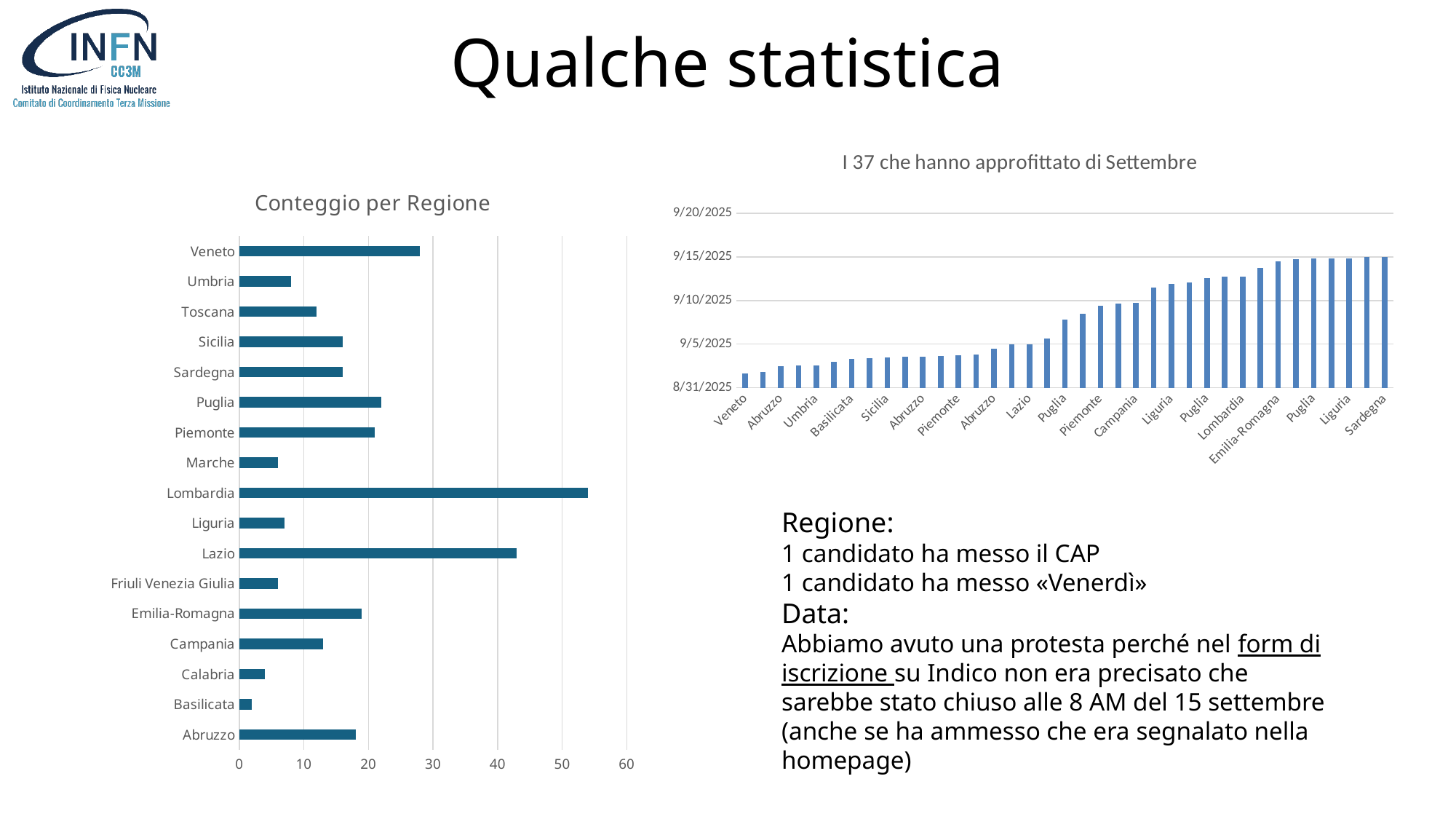
In the 'Conteggio per Regione' chart, which region has the lowest count? Basilicata In the 'Conteggio per Regione' chart, which has a larger value, Lazio or Veneto? Lazio In the 'Conteggio per Regione' chart, is the value for Lazio greater or less than 40? greater In the 'Conteggio per Regione' chart, is the value for Veneto greater or less than 20? greater In the 'Conteggio per Regione' chart, is the value for Basilicata greater or less than 10? less In the chart 'I 37 che hanno approfittato di Settembre', do the values rise or fall from left to right along the x axis? rise In the 'Conteggio per Regione' chart, which has a larger value, Marche or Abruzzo? Abruzzo What is the title of the chart on the right side of the slide? I 37 che hanno approfittato di Settembre What type of chart is the 'Conteggio per Regione' chart? bar chart In the 'Conteggio per Regione' chart, which region has the highest count? Lombardia How many regions are listed in the 'Conteggio per Regione' chart? 17